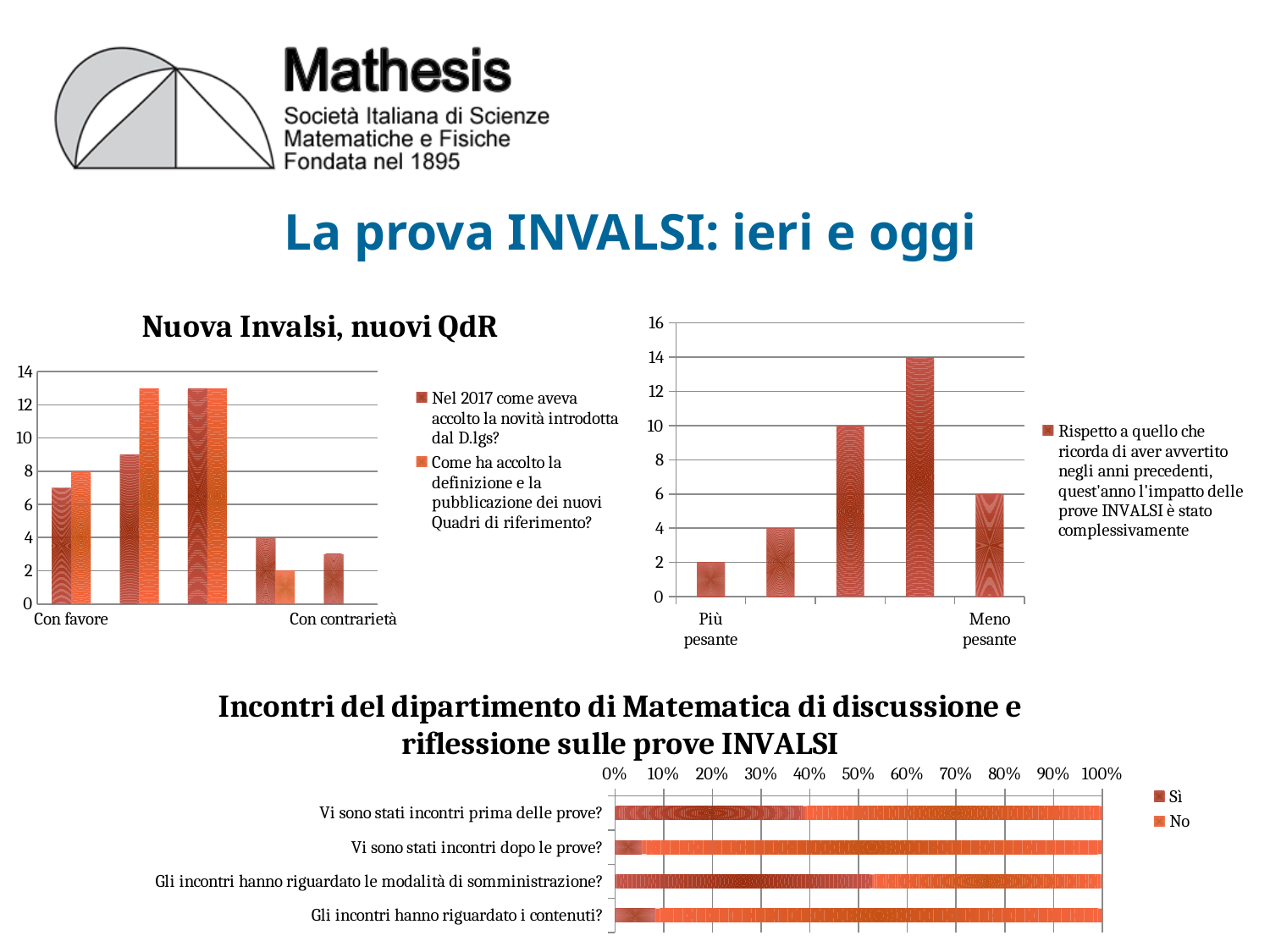
In the chart at the top right of the slide, what is the value for "Più pesante"? 2 In "Nuova Invalsi, nuovi QdR", what is the value for "Con favore" in the series "Come ha accolto la definizione e la pubblicazione dei nuovi Quadri di riferimento?"? 8 How many series does the legend of "Nuova Invalsi, nuovi QdR" list? 2 How many bars are plotted in the chart at the top right of the slide? 5 In "Incontri del dipartimento di Matematica di discussione e riflessione sulle prove INVALSI", is the "Sì" share for "Vi sono stati incontri dopo le prove?" greater or less than 10%? less In "Incontri del dipartimento di Matematica di discussione e riflessione sulle prove INVALSI", which question has the largest "Sì" share? Gli incontri hanno riguardato le modalità di somministrazione? In the chart at the top right of the slide, what is the difference between the values for "Meno pesante" and "Più pesante"? 4 In "Nuova Invalsi, nuovi QdR", is the value for "Con contrarietà" in the series "Nel 2017 come aveva accolto la novità introdotta dal D.lgs?" greater or less than 4? less In the chart at the top right of the slide, which is larger, the value for "Più pesante" or for "Meno pesante"? Meno pesante In "Nuova Invalsi, nuovi QdR", is the value for "Con favore" in the series "Nel 2017 come aveva accolto la novità introdotta dal D.lgs?" greater or less than 6? greater In the chart at the top right of the slide, what is the value for "Meno pesante"? 6 What kind of chart is "Nuova Invalsi, nuovi QdR"? Bar chart